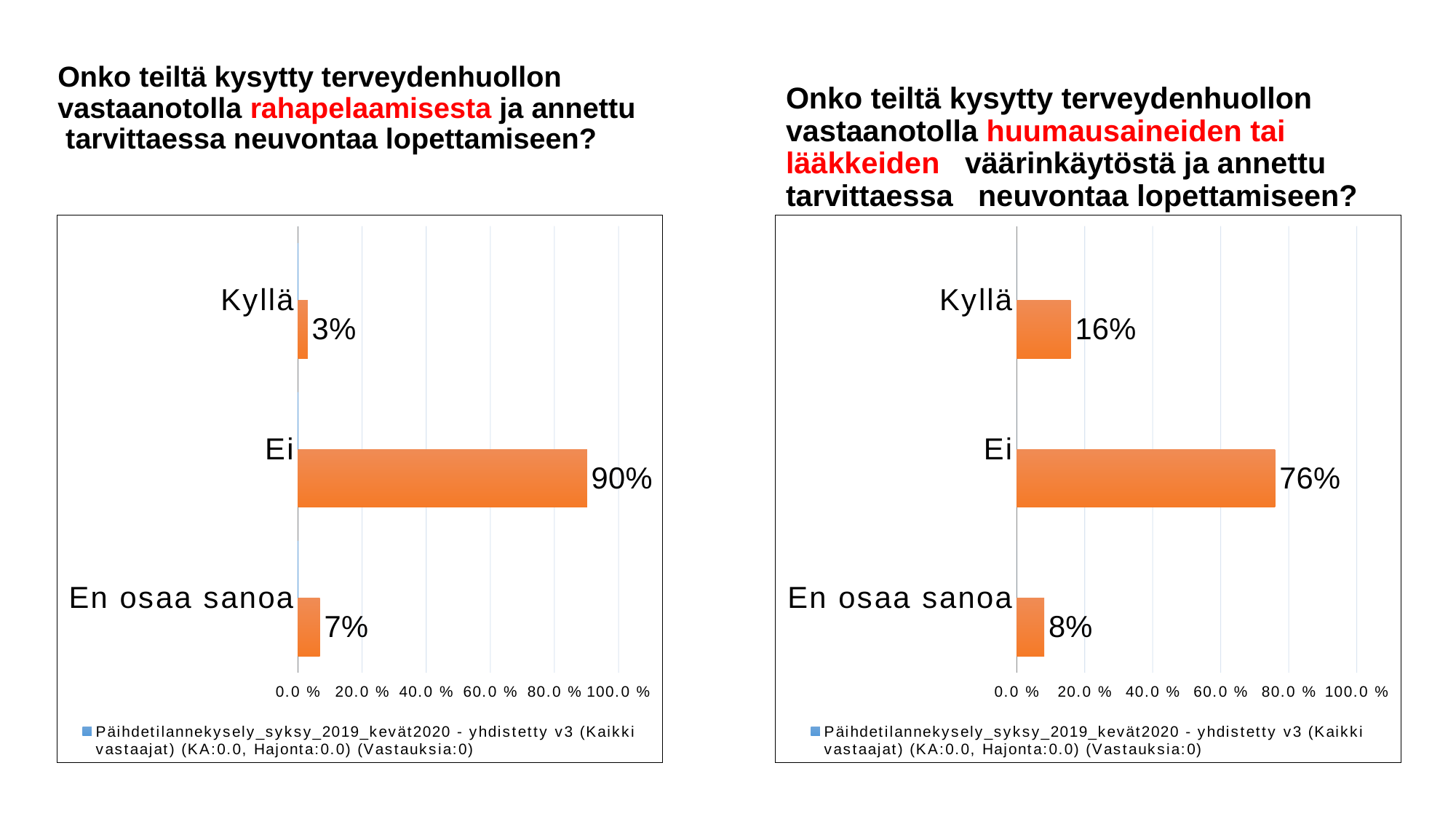
How many categories does the right chart (about huumausaineiden tai lääkkeiden väärinkäyttö) show? 3 In the left chart (about rahapelaaminen), is the value for Ei greater or less than 80.0 %? greater In the right chart (about huumausaineiden tai lääkkeiden väärinkäyttö), what is the value for Kyllä? 16% In the left chart (about rahapelaaminen), what is the value for Ei? 90% What kind of chart is the left chart (about rahapelaaminen)? Bar chart In the left chart (about rahapelaaminen), what is the difference between the values for En osaa sanoa and Kyllä? 4% In the right chart (about huumausaineiden tai lääkkeiden väärinkäyttö), what is the difference between the values for Ei and Kyllä? 60% Which is larger: the Kyllä value in the left chart or the Kyllä value in the right chart? The right chart (16%) In the right chart (about huumausaineiden tai lääkkeiden väärinkäyttö), what is the value for En osaa sanoa? 8% In the right chart (about huumausaineiden tai lääkkeiden väärinkäyttö), which category has the lowest value? En osaa sanoa In the left chart (about rahapelaaminen), what is the value for Kyllä? 3% In the left chart (about rahapelaaminen), which category has the highest value? Ei